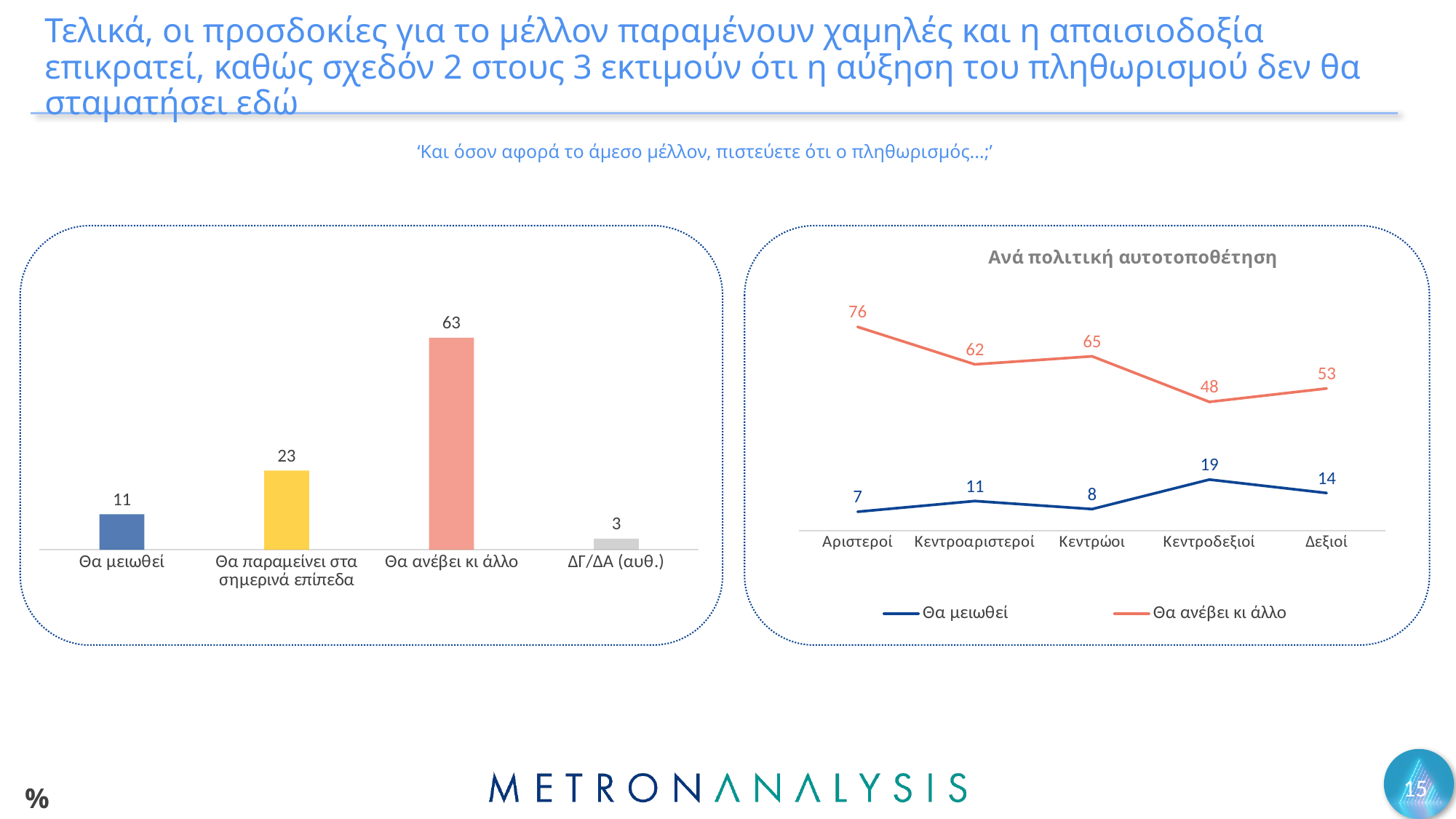
In the chart titled 'Ανά πολιτική αυτοτοποθέτηση', which category has the highest value for 'Θα μειωθεί'? Κεντροδεξιοί What kind of chart is the chart titled 'Ανά πολιτική αυτοτοποθέτηση'? line chart In the bar chart on the left, which category has the lowest value? ΔΓ/ΔΑ (αυθ.) What kind of chart is the chart on the left? bar chart In the bar chart on the left, what is the difference between 'Θα ανέβει κι άλλο' and 'Θα παραμείνει στα σημερινά επίπεδα'? 40 In the chart titled 'Ανά πολιτική αυτοτοποθέτηση', what is the value of 'Θα ανέβει κι άλλο' for Κεντρώοι? 65 In the chart titled 'Ανά πολιτική αυτοτοποθέτηση', which category has the lowest value for 'Θα ανέβει κι άλλο'? Κεντροδεξιοί In the bar chart on the left, what is the value for 'Θα ανέβει κι άλλο'? 63 In the chart titled 'Ανά πολιτική αυτοτοποθέτηση', is the value of 'Θα μειωθεί' larger for Κεντροαριστεροί or for Δεξιοί? Δεξιοί How many series does the legend of the chart titled 'Ανά πολιτική αυτοτοποθέτηση' list? 2 In the bar chart on the left, how many categories are shown? 4 In the chart titled 'Ανά πολιτική αυτοτοποθέτηση', what is the difference between 'Θα ανέβει κι άλλο' and 'Θα μειωθεί' for Αριστεροί? 69